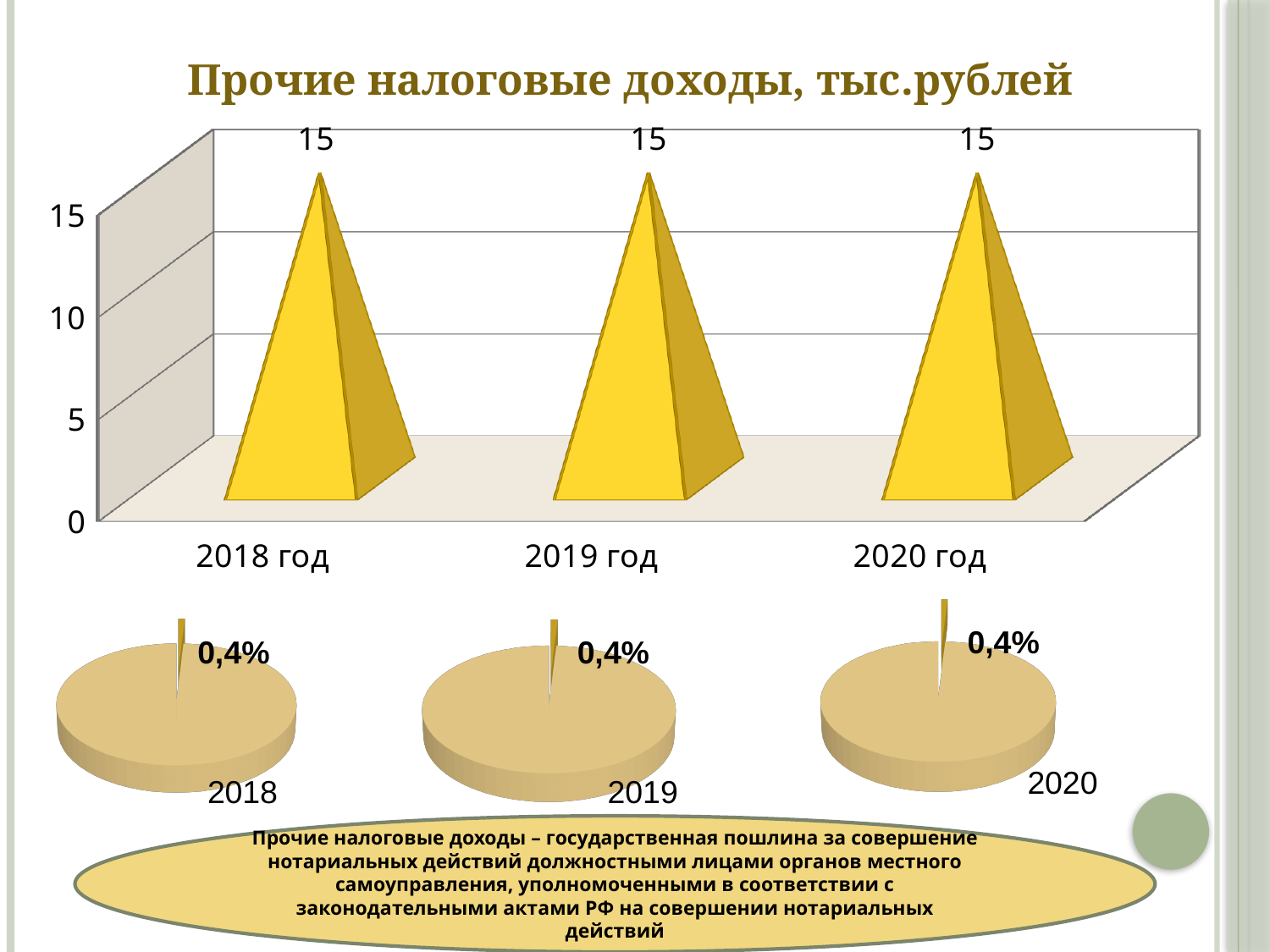
What is the title of the bar chart? Прочие налоговые доходы, тыс.рублей In the bar chart, what is the value for 2019 год? 15 In the pie chart labelled 2018, what share does the highlighted slice have? 0,4% How many categories does the bar chart show? 3 What kind of chart is the top chart on the slide? bar chart In the bar chart, do the values rise, fall or stay the same from 2018 год to 2020 год? stay the same In the bar chart, what is the value for 2018 год? 15 In the bar chart, what is the difference between the values for 2018 год and 2020 год? 0 In the pie chart labelled 2020, what share does the highlighted slice have? 0,4% In the bar chart, is the value for 2019 год greater or less than 10? greater In the bar chart, what is the value for 2020 год? 15 How many pie charts are shown on the slide? 3